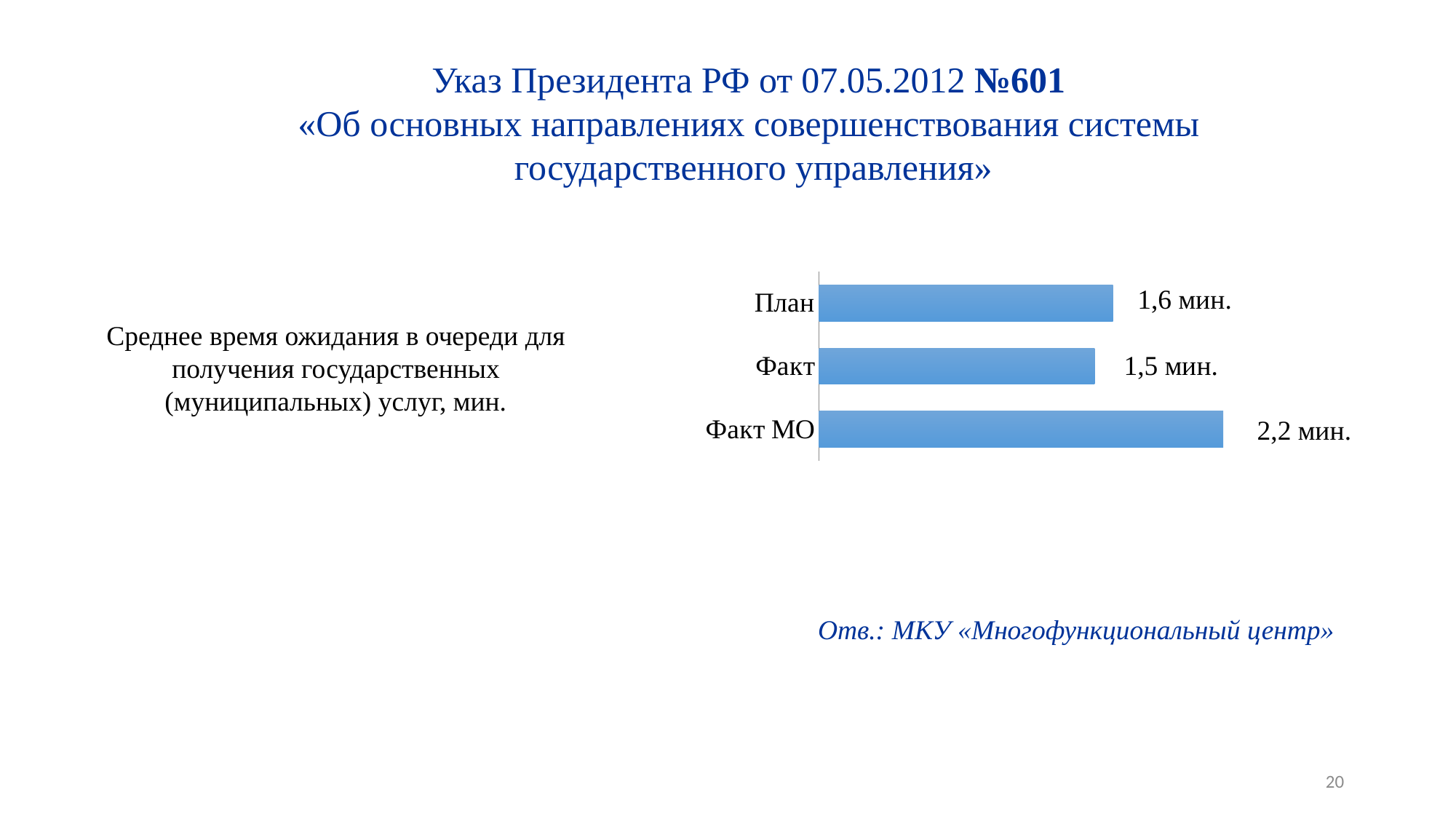
What is the value for Факт МО? 2,2 мин. Which category has the highest value? Факт МО What colour are the bars in the chart? blue Which category has the lowest value? Факт How many categories are shown in the chart? 3 What is the value for Факт? 1,5 мин. What does the text to the left of the chart say the chart measures? Среднее время ожидания в очереди для получения государственных (муниципальных) услуг, мин. What is the difference between the values for План and Факт? 0,1 мин. What kind of chart is shown on the slide? bar chart What is the value for План? 1,6 мин. What is the difference between the values for Факт МО and План? 0,6 мин. Which is larger, the value for Факт МО or the value for Факт? Факт МО